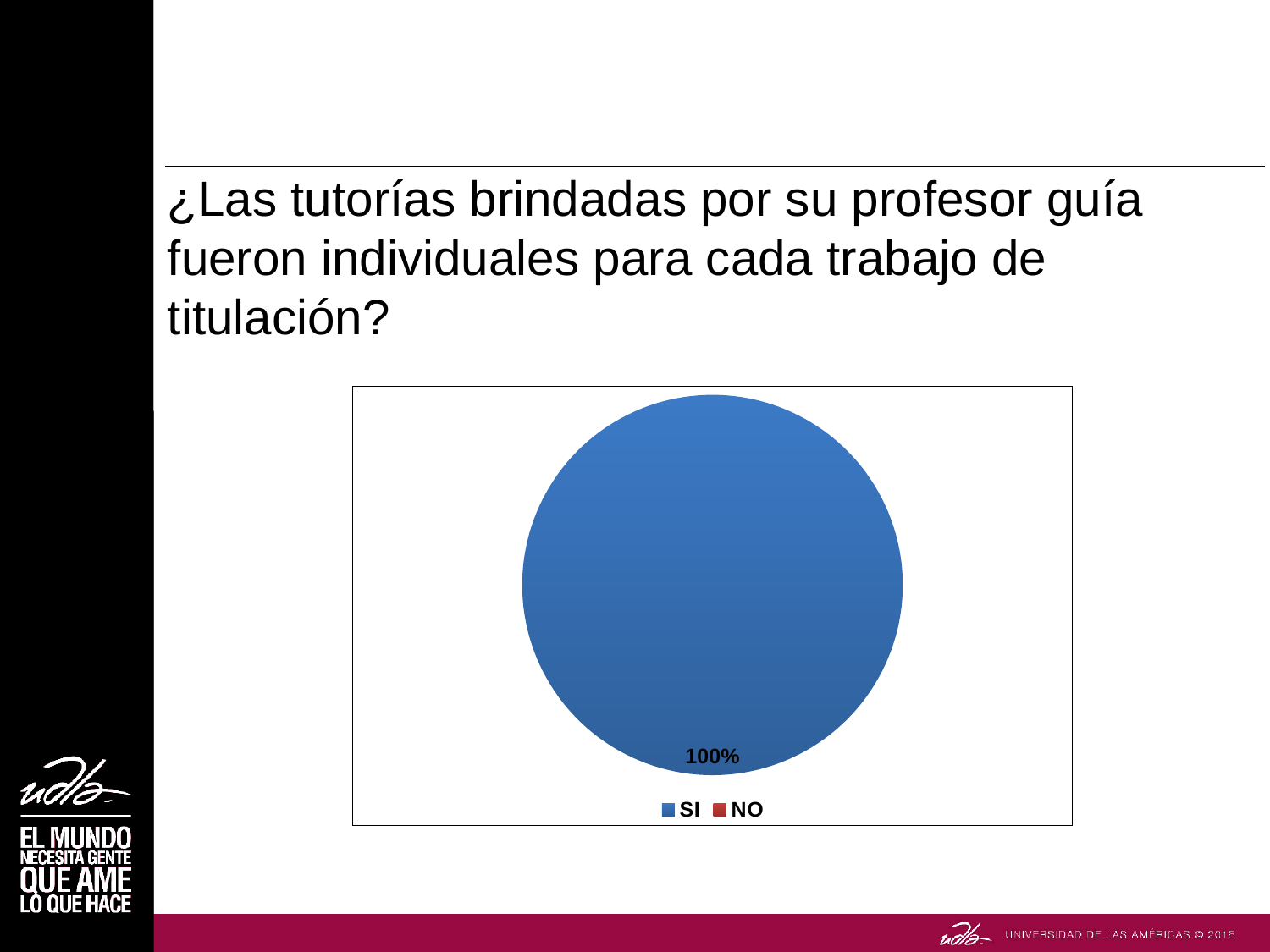
Which of the two categories, SI or NO, has the larger share of the pie? SI What are the two legend entries of the pie chart? SI and NO What kind of chart is shown on the slide? pie chart Which category has the largest share of the pie chart? SI What share of the pie does the SI category take? 100% What percentage is shown for the SI slice of the pie chart? 100% How many entries does the legend of the pie chart list? 2 What colour is the SI slice in the pie chart? blue How many data labels are printed on the pie chart? 1